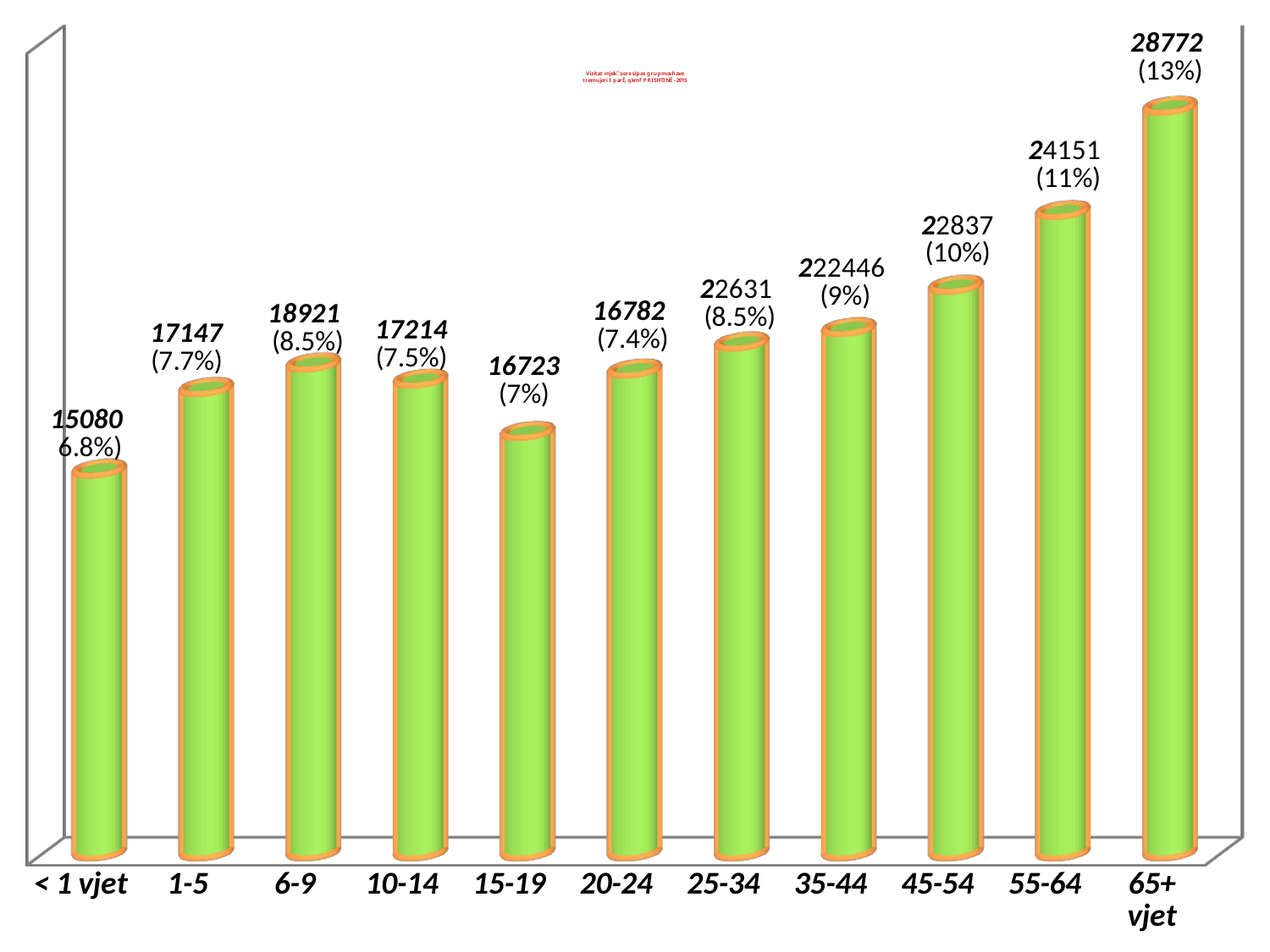
What is the value for the 15-19 age group? 16723 Which has a larger value, 25-34 or 1-5? 25-34 Which age group has the lowest value? < 1 vjet What is the value for the 65+ vjet age group? 28772 Which has a larger value, 6-9 or 10-14? 6-9 How many age groups are shown on the chart? 11 What is the difference between the values for 65+ vjet and < 1 vjet? 13692 What kind of chart is shown on the slide? bar chart What is the difference between the values for 55-64 and 45-54? 1314 What is the value for the < 1 vjet age group? 15080 What percentage is shown for the 55-64 age group? 11% Which age group has the highest value? 65+ vjet